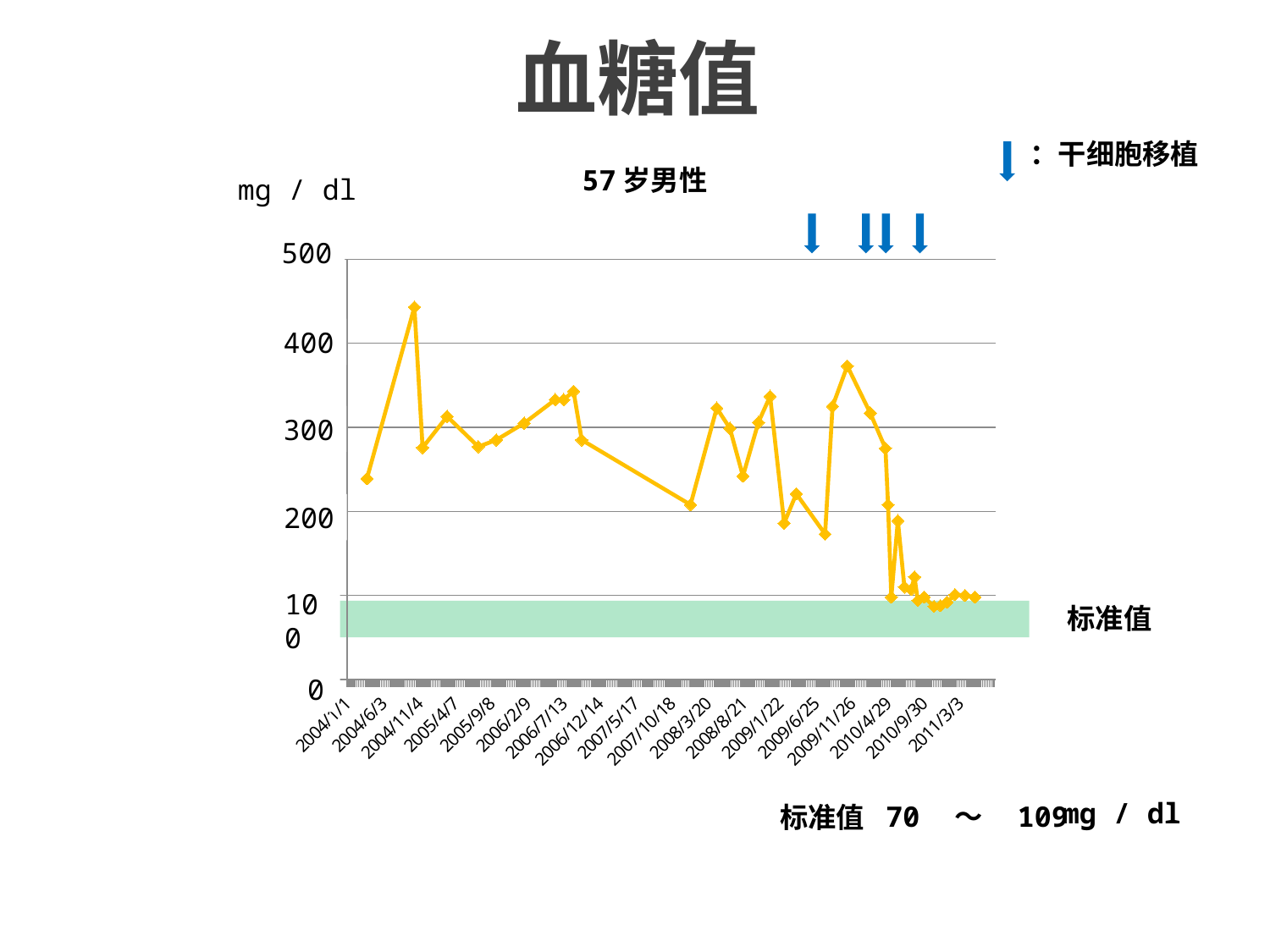
Is the first plotted value (at 2004/1/1) greater or less than 200? greater Is the highest value on the chart greater or less than 500? less Is the last plotted value (around 2011/3/3) greater or less than 200? less Overall, do the blood glucose values rise or fall from the start of the chart to the end? fall What is the title of the slide? 血糖值 What kind of chart is shown on the slide? line chart What unit is shown on the y axis of the chart? mg / dl